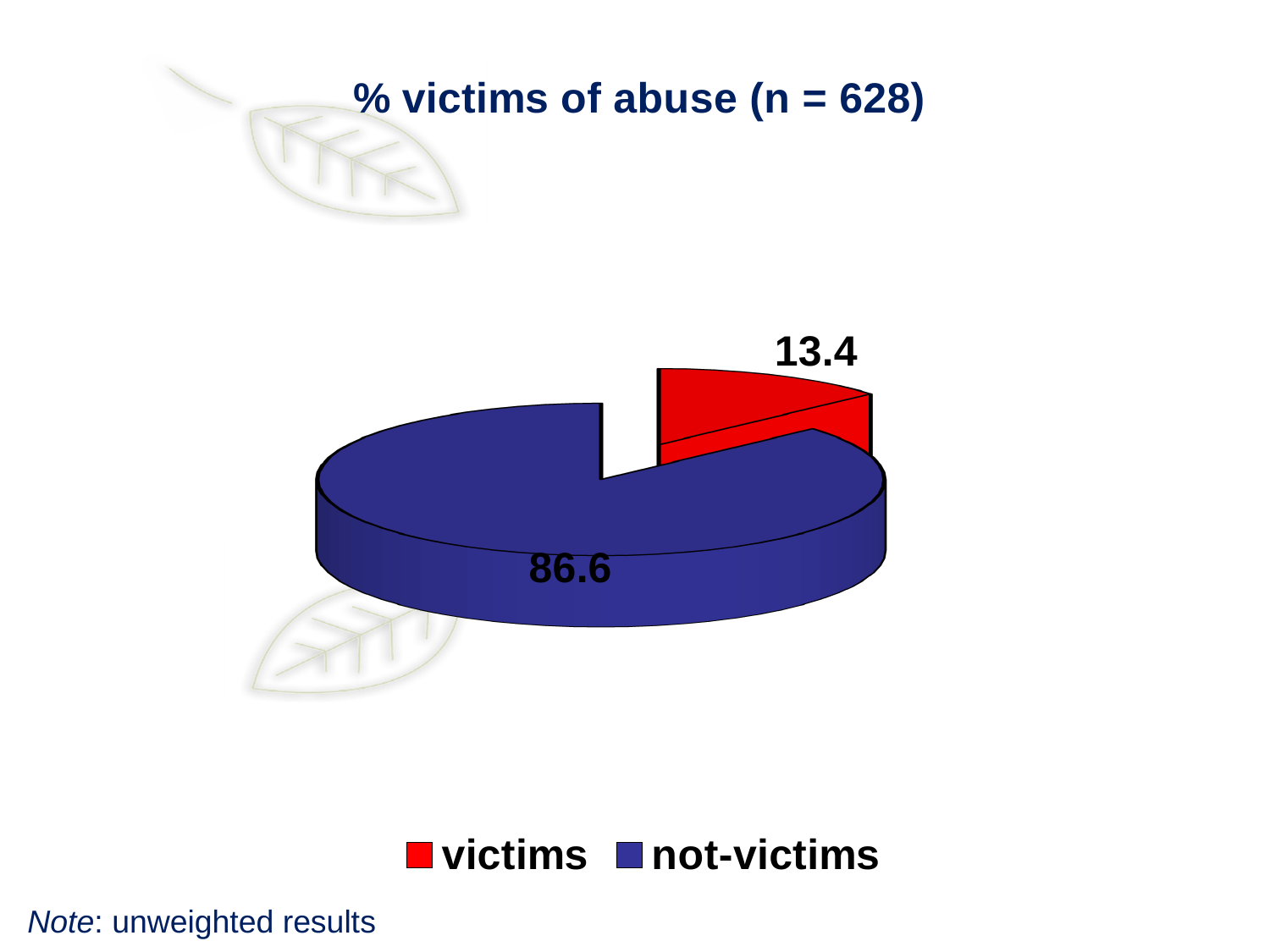
Which is larger, victims or not-victims? not-victims What is the total of the two slice values? 100 What is the value for victims? 13.4 What is the difference between the not-victims and victims values? 73.2 What kind of chart is shown on the slide? pie chart What is the value for not-victims? 86.6 How many entries does the legend list? 2 What colour is the victims slice? red Which category has the smallest slice? victims Which category has the largest slice? not-victims What is the title of the chart? % victims of abuse (n = 628) How many slices does the pie chart have? 2